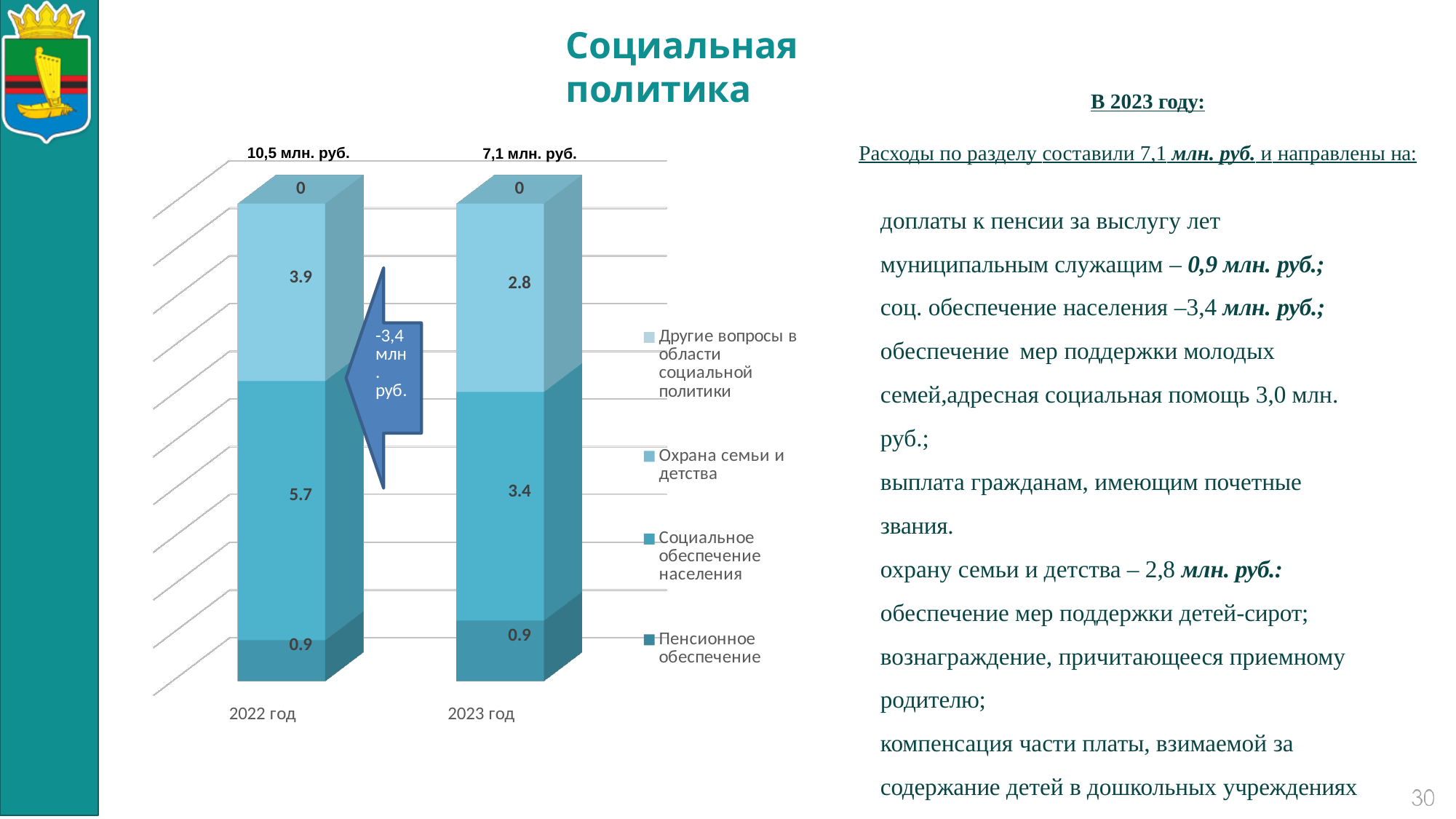
What is the value for Другие вопросы в области социальной политики in 2022 год? 0 What is the total of the stacked bar for 2022 год? 10,5 млн. руб. What is the value for Социальное обеспечение населения in 2022 год? 5.7 What type of chart is shown on the slide? Stacked bar chart How many categories (years) are shown on the x axis of the chart? 2 What is the difference between the Социальное обеспечение населения values for 2022 год and 2023 год? 2.3 What is the value for Пенсионное обеспечение in 2023 год? 0.9 How many series does the chart legend list? 4 Which series has the highest value in 2023 год? Социальное обеспечение населения What is the value for Охрана семьи и детства in 2023 год? 2.8 Which year has the larger value for Охрана семьи и детства, 2022 год or 2023 год? 2022 год What is the total of the stacked bar for 2023 год? 7,1 млн. руб.